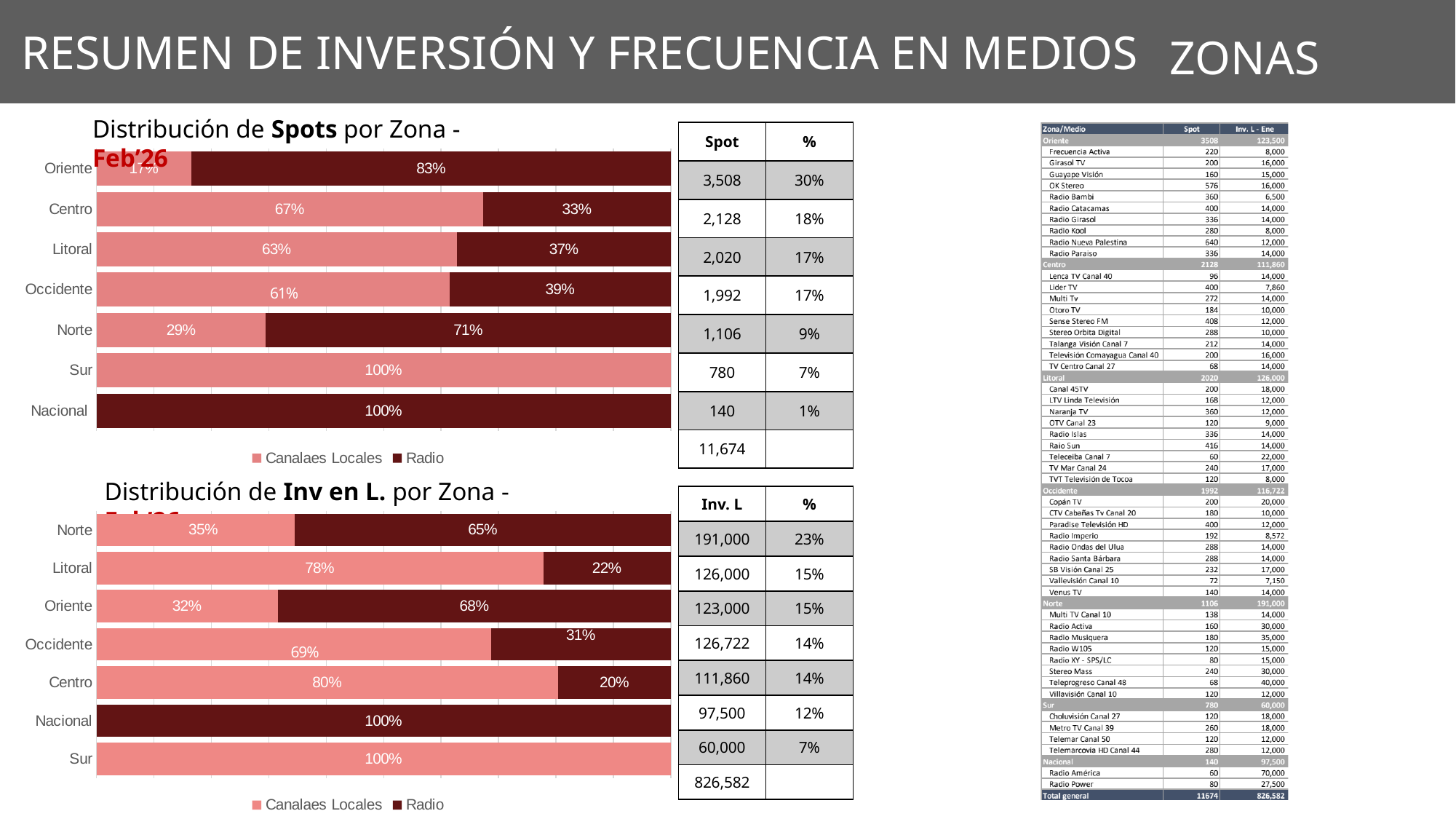
In the 'Distribución de Inv en L. por Zona' chart, what is the Radio share for Oriente? 68% In the 'Distribución de Inv en L. por Zona' chart, which zone has the lowest Radio share among zones with a non-zero Radio share? Centro In the 'Distribución de Inv en L. por Zona' chart, is the Canalaes Locales share larger for Litoral or for Occidente? Litoral In the 'Distribución de Spots por Zona' chart, how many zones are shown? 7 In the 'Distribución de Inv en L. por Zona' chart, what is the Canalaes Locales share for Centro? 80% In the 'Distribución de Spots por Zona' chart, which zone has the highest Radio share? Nacional In the 'Distribución de Spots por Zona' chart, what is the Canalaes Locales share for Centro? 67% In the 'Distribución de Spots por Zona' chart, what is the Radio share for Norte? 71% In the 'Distribución de Spots por Zona' chart, what is the difference between the Canalaes Locales share and the Radio share for Litoral? 26% What type of chart is the 'Distribución de Spots por Zona' chart? Stacked bar chart In the 'Distribución de Spots por Zona' chart, what is the Radio share for Oriente? 83% How many series does the legend of the 'Distribución de Inv en L. por Zona' chart list? 2